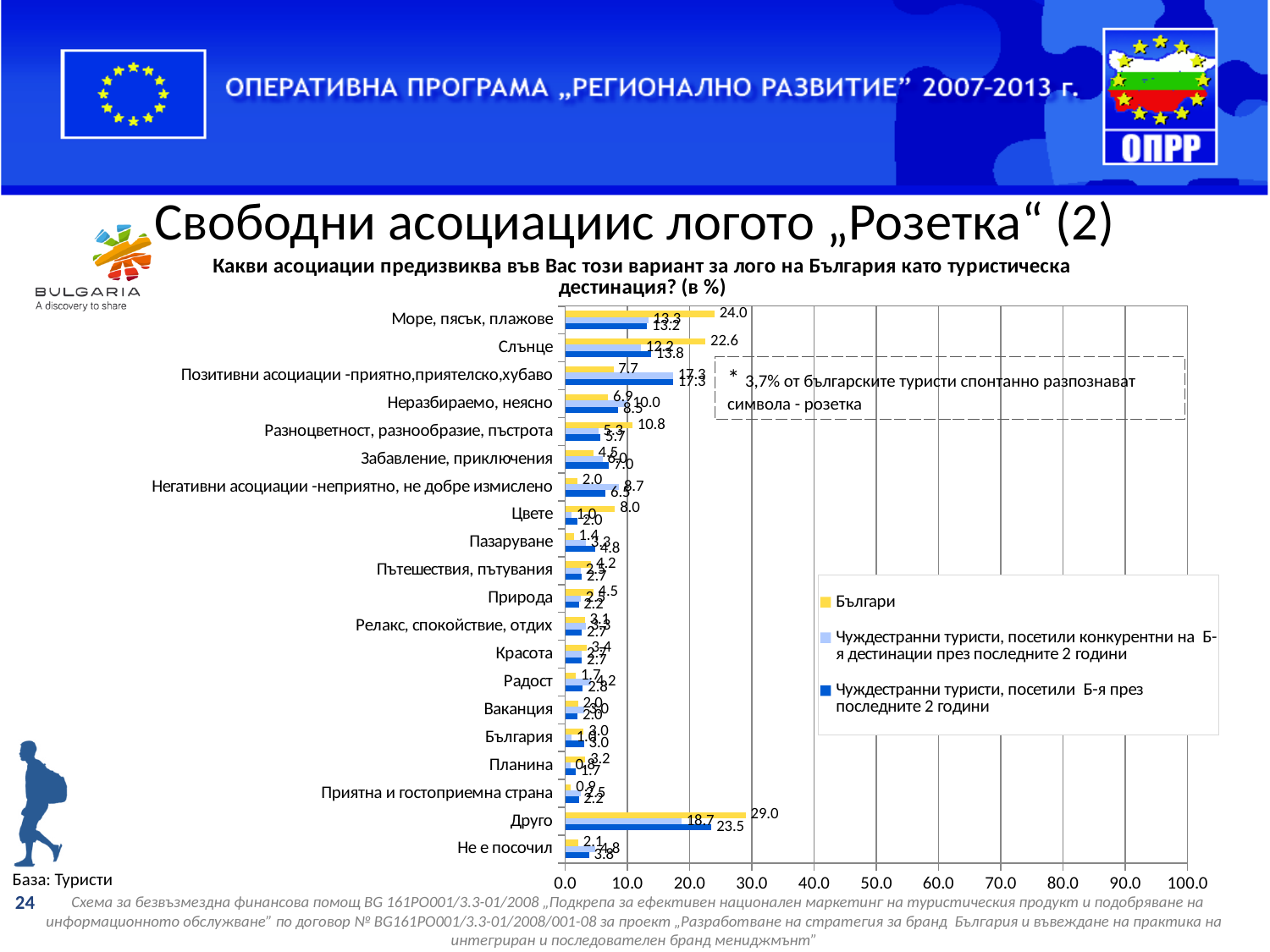
How many categories are plotted on the chart? 20 Is the value for Българи in the category "Друго" greater or less than 20.0? greater How many series does the chart legend list? 3 What kind of chart is shown on the slide? bar chart What is the value for "Чуждестранни туристи, посетили Б-я през последните 2 години" in the category "Друго"? 23.5 What is the value for Българи in the category "Друго"? 29.0 What is the value for Българи in the category "Слънце"? 22.6 What is the difference between the Българи values for "Море, пясък, плажове" and "Слънце"? 1.4 In the category "Друго", what is the difference between the value for Българи and the value for "Чуждестранни туристи, посетили Б-я през последните 2 години"? 5.5 For Българи, which is larger: the value for "Море, пясък, плажове" or the value for "Слънце"? Море, пясък, плажове What is the value for Българи in the category "Море, пясък, плажове"? 24.0 Which category has the highest value for Българи? Друго